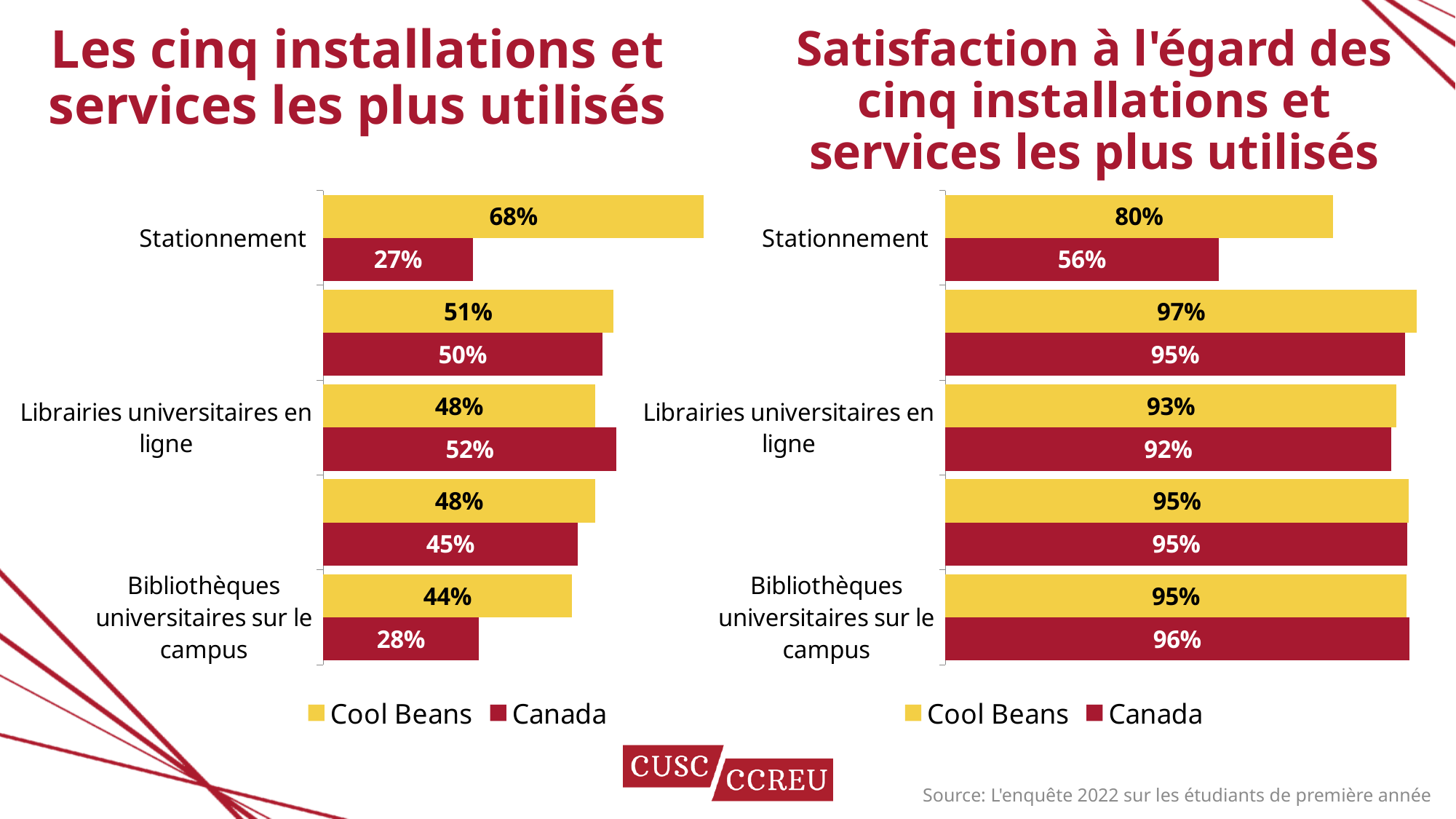
In the left chart, 'Les cinq installations et services les plus utilisés', what is the difference between the Cool Beans and Canada values for Stationnement? 41% In the left chart, 'Les cinq installations et services les plus utilisés', what is the Canada value for Bibliothèques universitaires sur le campus? 28% How many series does the legend of the left chart, 'Les cinq installations et services les plus utilisés', list? 2 In the left chart, 'Les cinq installations et services les plus utilisés', which category has the highest Cool Beans value? Stationnement In the right chart, 'Satisfaction à l'égard des cinq installations et services les plus utilisés', what is the Canada value for Stationnement? 56% What type of chart is the right chart, 'Satisfaction à l'égard des cinq installations et services les plus utilisés'? Bar chart In the left chart, 'Les cinq installations et services les plus utilisés', which is larger for Librairies universitaires en ligne: Cool Beans or Canada? Canada How many categories are shown in the right chart, 'Satisfaction à l'égard des cinq installations et services les plus utilisés'? 5 In the right chart, 'Satisfaction à l'égard des cinq installations et services les plus utilisés', what is the Cool Beans value for Librairies universitaires en ligne? 93% In the right chart, 'Satisfaction à l'égard des cinq installations et services les plus utilisés', what is the difference between the Cool Beans and Canada values for Stationnement? 24% In the left chart, 'Les cinq installations et services les plus utilisés', what is the Cool Beans value for Stationnement? 68% In the right chart, 'Satisfaction à l'égard des cinq installations et services les plus utilisés', which category has the lowest Canada value? Stationnement